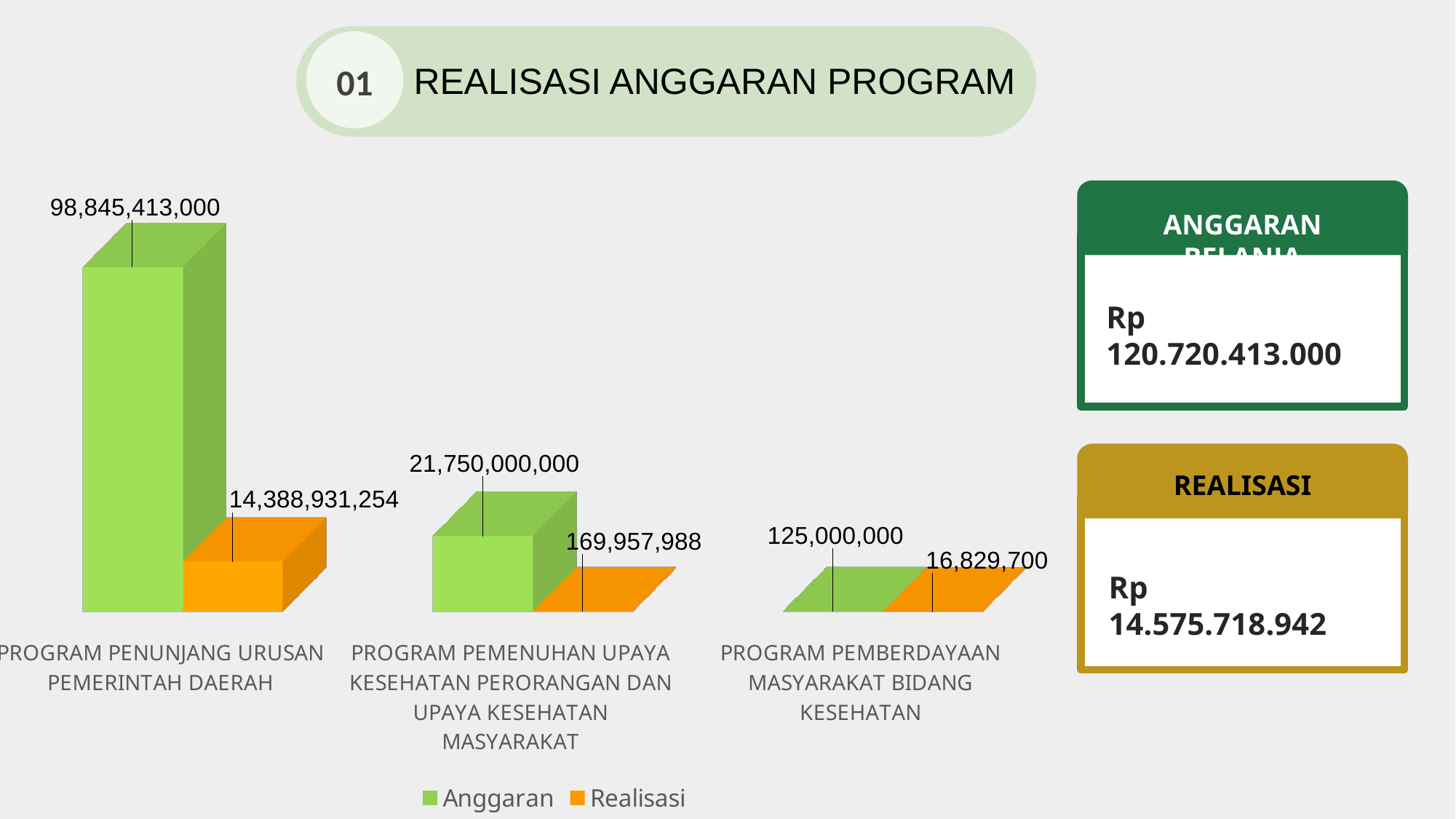
What is the Anggaran value for Program Pemenuhan Upaya Kesehatan Perorangan dan Upaya Kesehatan Masyarakat? 21,750,000,000 What is the difference between the Anggaran and Realisasi values for Program Penunjang Urusan Pemerintah Daerah? 84,456,481,746 What kind of chart is shown on the slide? Bar chart Which program has the lowest Realisasi value? Program Pemberdayaan Masyarakat Bidang Kesehatan How many series does the chart legend list? 2 Which program has the highest Anggaran value? Program Penunjang Urusan Pemerintah Daerah Which is larger: the Realisasi for Program Pemenuhan Upaya Kesehatan Perorangan dan Upaya Kesehatan Masyarakat or the Anggaran for Program Pemberdayaan Masyarakat Bidang Kesehatan? Realisasi for Program Pemenuhan Upaya Kesehatan Perorangan dan Upaya Kesehatan Masyarakat What is the Realisasi value for Program Pemberdayaan Masyarakat Bidang Kesehatan? 16,829,700 What is the difference between the Anggaran and Realisasi values for Program Pemberdayaan Masyarakat Bidang Kesehatan? 108,170,300 How many programs (categories) are shown in the chart? 3 What is the Realisasi value for Program Penunjang Urusan Pemerintah Daerah? 14,388,931,254 What is the Anggaran value for Program Penunjang Urusan Pemerintah Daerah? 98,845,413,000